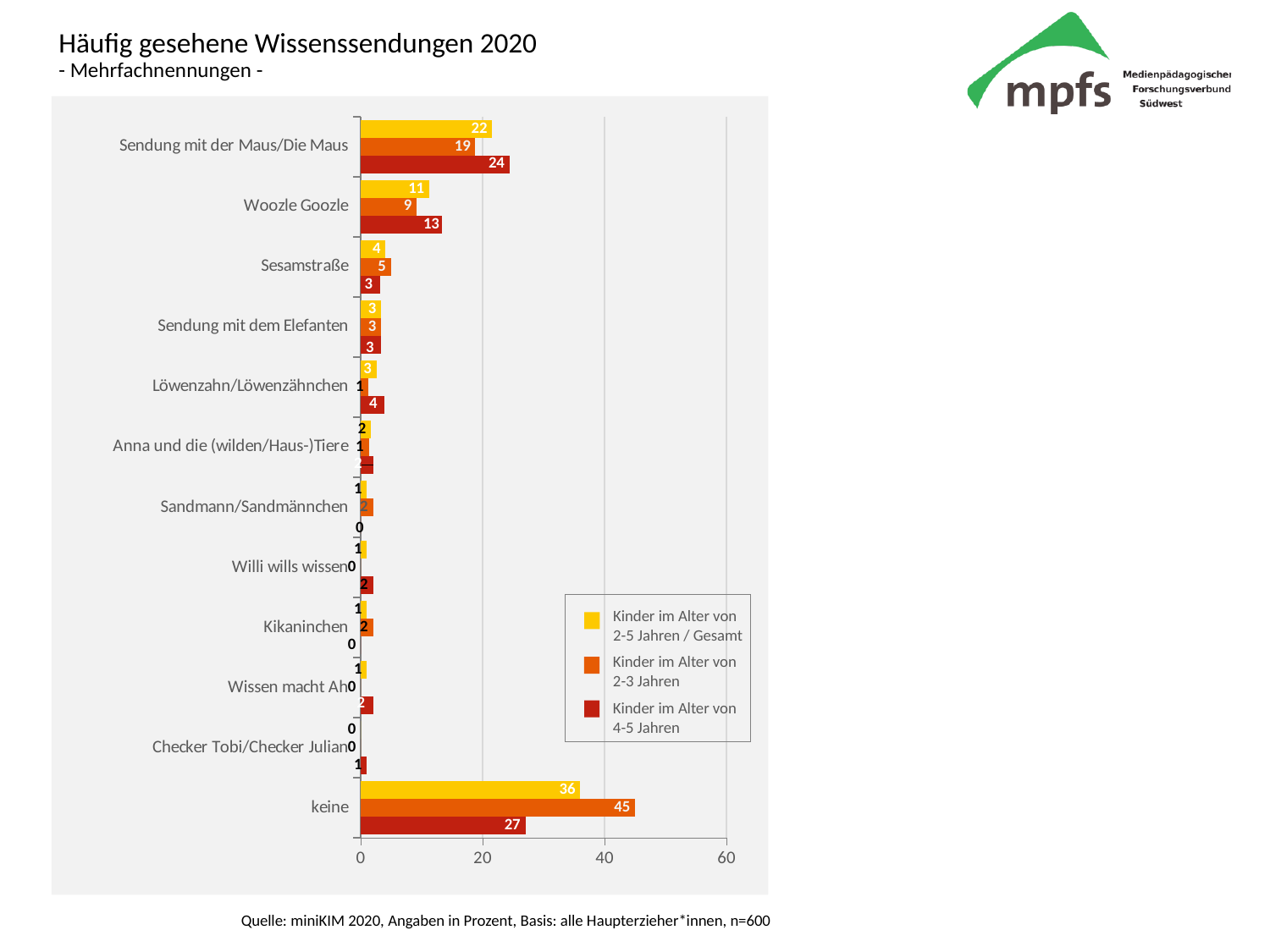
Which category has the highest value for Kinder im Alter von 2-3 Jahren? keine What is the title of the chart? Häufig gesehene Wissenssendungen 2020 How many categories (programmes) are shown on the y axis? 12 What is the value for keine for Kinder im Alter von 2-5 Jahren / Gesamt? 36 Among the named programmes (excluding keine), which has the highest value for Kinder im Alter von 2-5 Jahren / Gesamt? Sendung mit der Maus/Die Maus Is the value for keine for Kinder im Alter von 2-3 Jahren greater or less than 40? greater What is the value for Woozle Goozle for Kinder im Alter von 2-3 Jahren? 9 For Sendung mit der Maus/Die Maus, which is larger: the value for 2-3 Jahren or for 4-5 Jahren? 4-5 Jahren What type of chart is shown on the slide? bar chart How many series does the legend list? 3 What is the difference between the 2-3 Jahren and 4-5 Jahren values for keine? 18 What is the value for Sendung mit der Maus/Die Maus for Kinder im Alter von 4-5 Jahren? 24